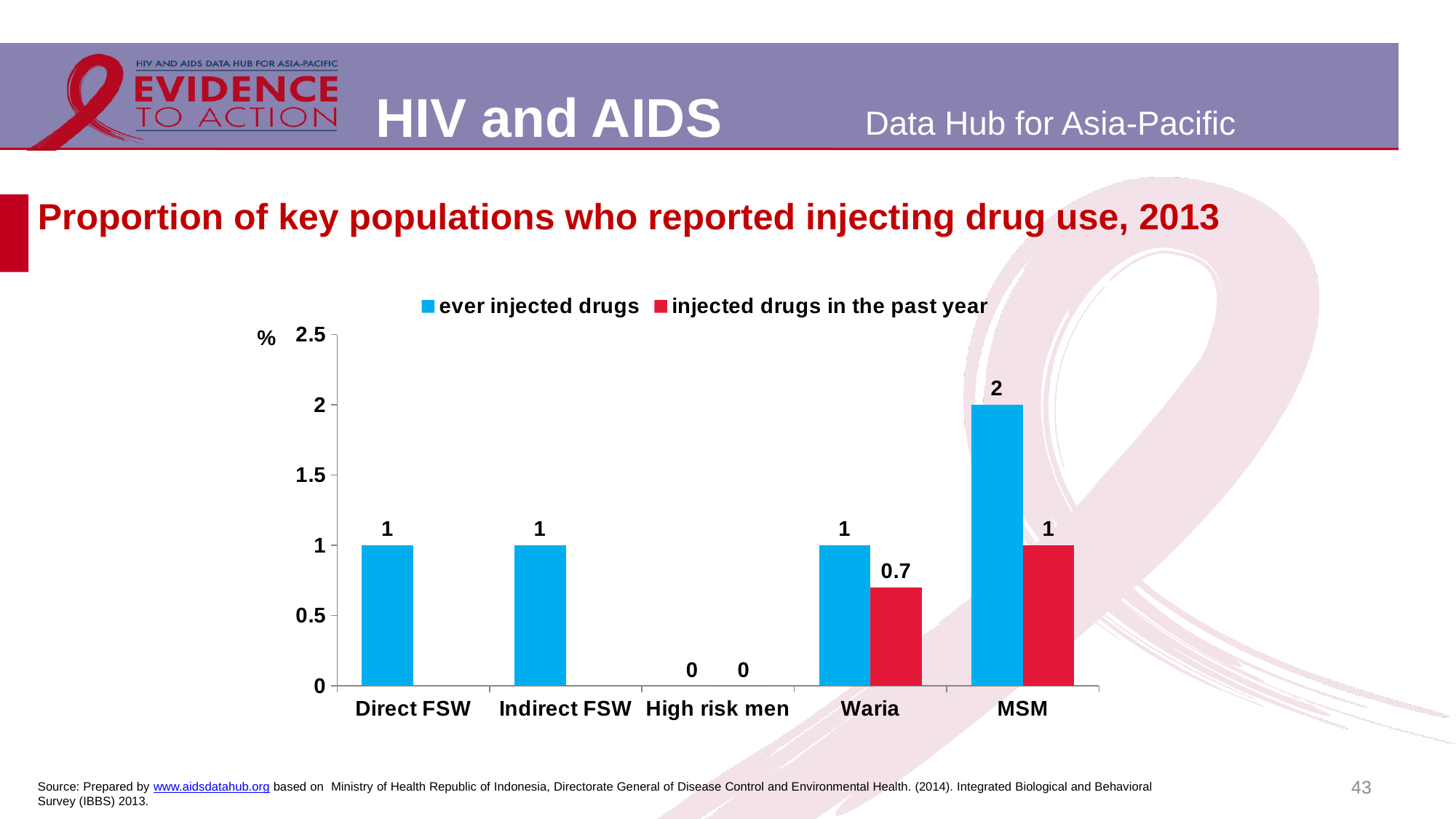
For MSM, which is larger: the 'ever injected drugs' value or the 'injected drugs in the past year' value? ever injected drugs What is the value for MSM in the 'ever injected drugs' series? 2 How many categories are shown on the x axis? 5 Which category has the lowest value in the 'ever injected drugs' series? High risk men Which category has the highest value in the 'ever injected drugs' series? MSM What is the value for High risk men in the 'ever injected drugs' series? 0 How many series does the legend list? 2 What is the difference between the 'ever injected drugs' value for MSM and the 'ever injected drugs' value for Waria? 1 What colour represents the 'injected drugs in the past year' series? red What kind of chart is shown on the slide? bar chart What is the value for Direct FSW in the 'ever injected drugs' series? 1 What is the value for Waria in the 'injected drugs in the past year' series? 0.7